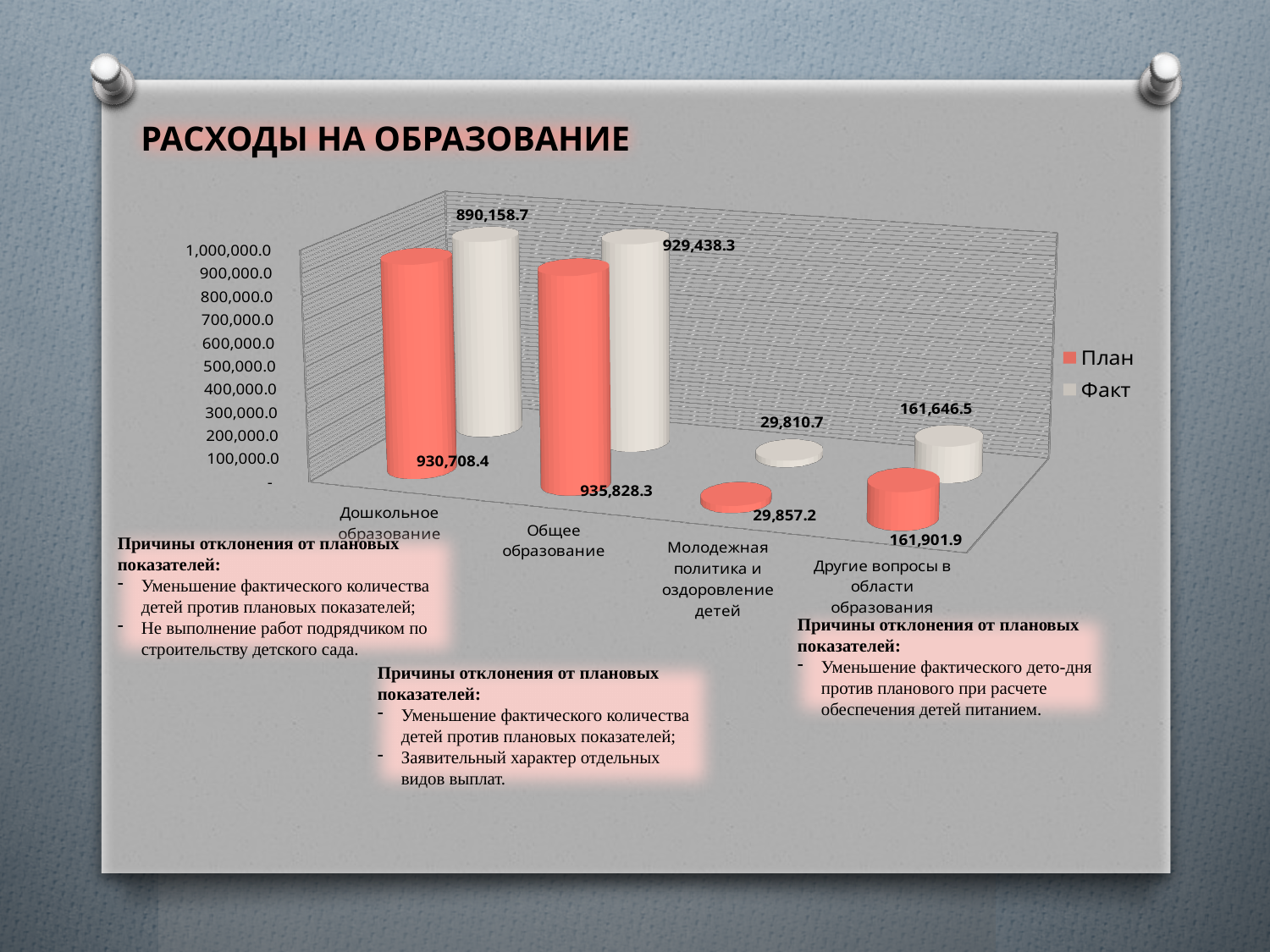
What is the Факт value for Дошкольное образование? 890,158.7 What is the difference between the План and Факт values for Дошкольное образование? 40,549.7 How many series does the legend list? 2 Which category has the lowest Факт value? Молодежная политика и оздоровление детей Which category has the highest План value? Общее образование What is the План value for Молодежная политика и оздоровление детей? 29,857.2 What is the difference between the План and Факт values for Общее образование? 6,390.0 What is the Факт value for Другие вопросы в области образования? 161,646.5 Which is larger for Другие вопросы в области образования, the План value or the Факт value? План How many categories are shown on the chart? 4 What is the Факт value for Общее образование? 929,438.3 What is the План value for Дошкольное образование? 930,708.4